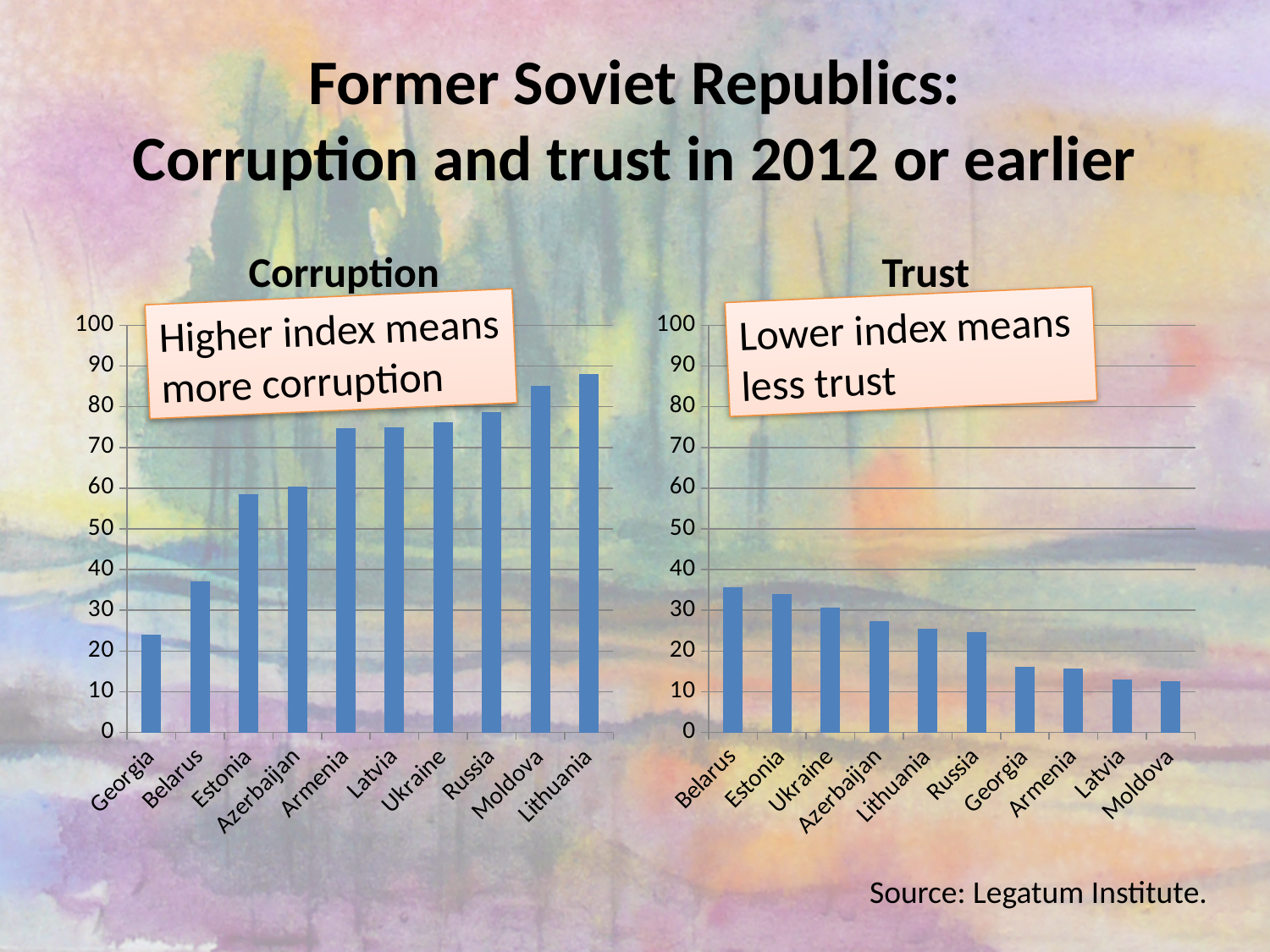
In the Corruption chart, which country has the highest value? Lithuania In the Corruption chart, which country has the lowest value? Georgia In the Trust chart, do the values rise or fall from left to right? Fall How many countries are shown in the Corruption chart? 10 In the Trust chart, which country has the highest value? Belarus What kind of chart is the Trust chart? Bar chart In the Corruption chart, which has the larger value, Georgia or Belarus? Belarus In the Trust chart, is the value for Moldova greater or less than 20? less In the Corruption chart, is the value for Georgia greater or less than 30? less In the Corruption chart, is the value for Lithuania greater or less than 80? greater In the Trust chart, which has the larger value, Belarus or Georgia? Belarus